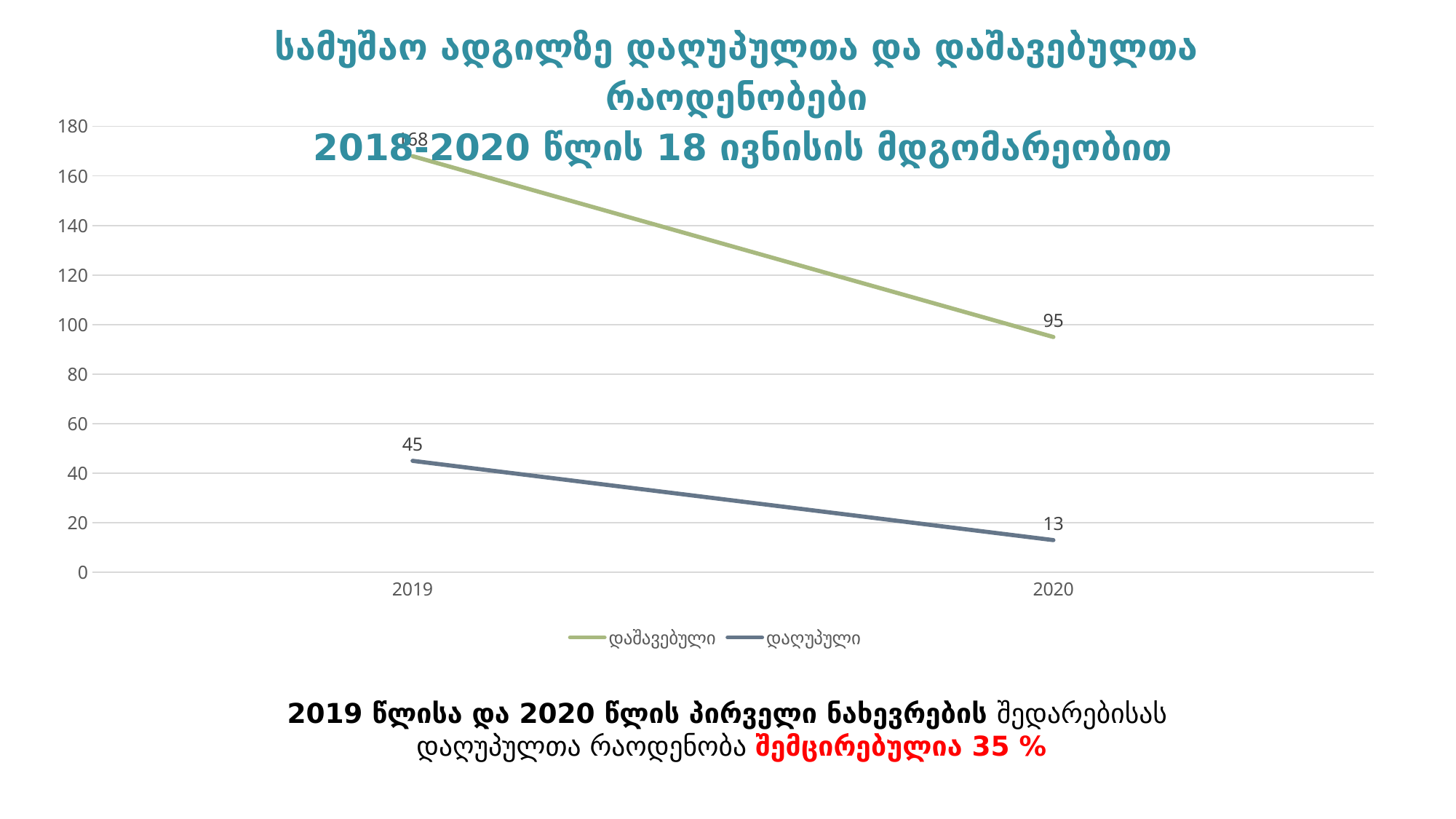
What is the value of the დაღუპული series in 2020? 13 In 2020, which series has the higher value, დაშავებული or დაღუპული? დაშავებული What colour is the line for the დაშავებული series? green Does the დაშავებული series rise or fall from 2019 to 2020? fall How many years are shown on the x axis? 2 What kind of chart is shown on the slide? line chart What is the value of the დაღუპული series in 2019? 45 Does the დაღუპული series rise or fall from 2019 to 2020? fall How many series does the legend list? 2 Is the value for დაშავებული in 2019 greater or less than 160? greater By how much did the დაღუპული value decrease from 2019 to 2020? 32 What is the value of the დაშავებული series in 2020? 95